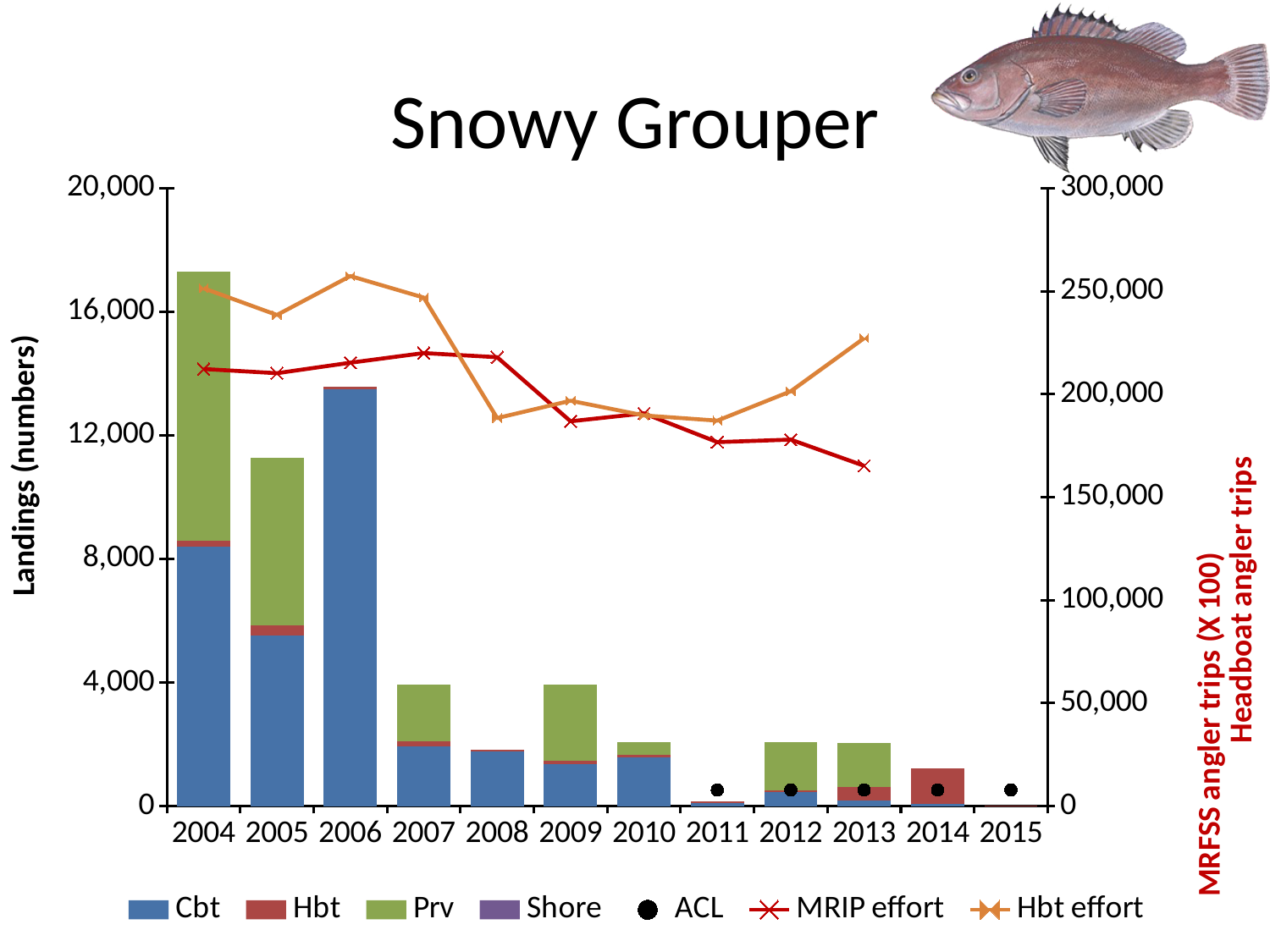
Is the total landings value for 2006 greater or less than 12,000? greater In which year is Hbt effort highest? 2006 Which year has larger total landings, 2005 or 2006? 2006 Is the total landings value for 2004 greater or less than 16,000? greater How many series does the legend list? 7 What kind of chart is shown on the slide? A bar chart combined with line series Which year has the highest total landings bar? 2004 Does the MRIP effort line rise or fall from 2007 to 2013? fall How many years are shown along the x axis? 12 Which year has the lowest total landings bar? 2015 Is the MRIP effort value for 2013 greater or less than 200,000? less What is the label of the left vertical axis? Landings (numbers)